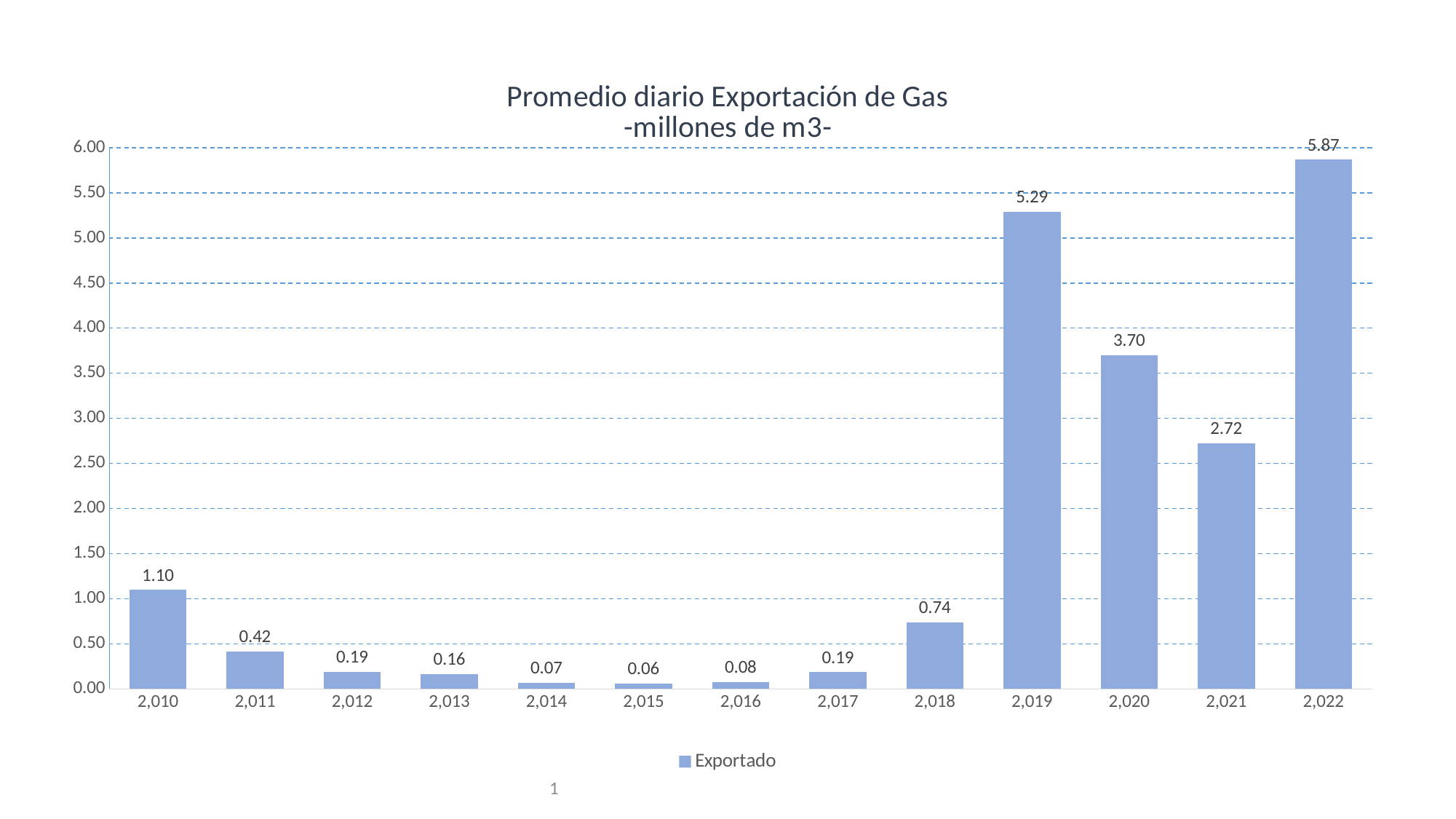
Which is larger, the value for 2,010 or the value for 2,018? 2,010 Which year has the lowest value? 2,015 What is the difference between the values for 2,020 and 2,021? 0.98 What kind of chart is this? bar chart What is the value for 2,021? 2.72 Which year has the highest value? 2,022 What is the name of the series shown in the legend? Exportado Is the value for 2,020 greater or less than 3.50? greater How many years are shown on the x axis? 13 What is the value for 2,015? 0.06 What is the value for 2,019? 5.29 What is the difference between the values for 2,022 and 2,019? 0.58